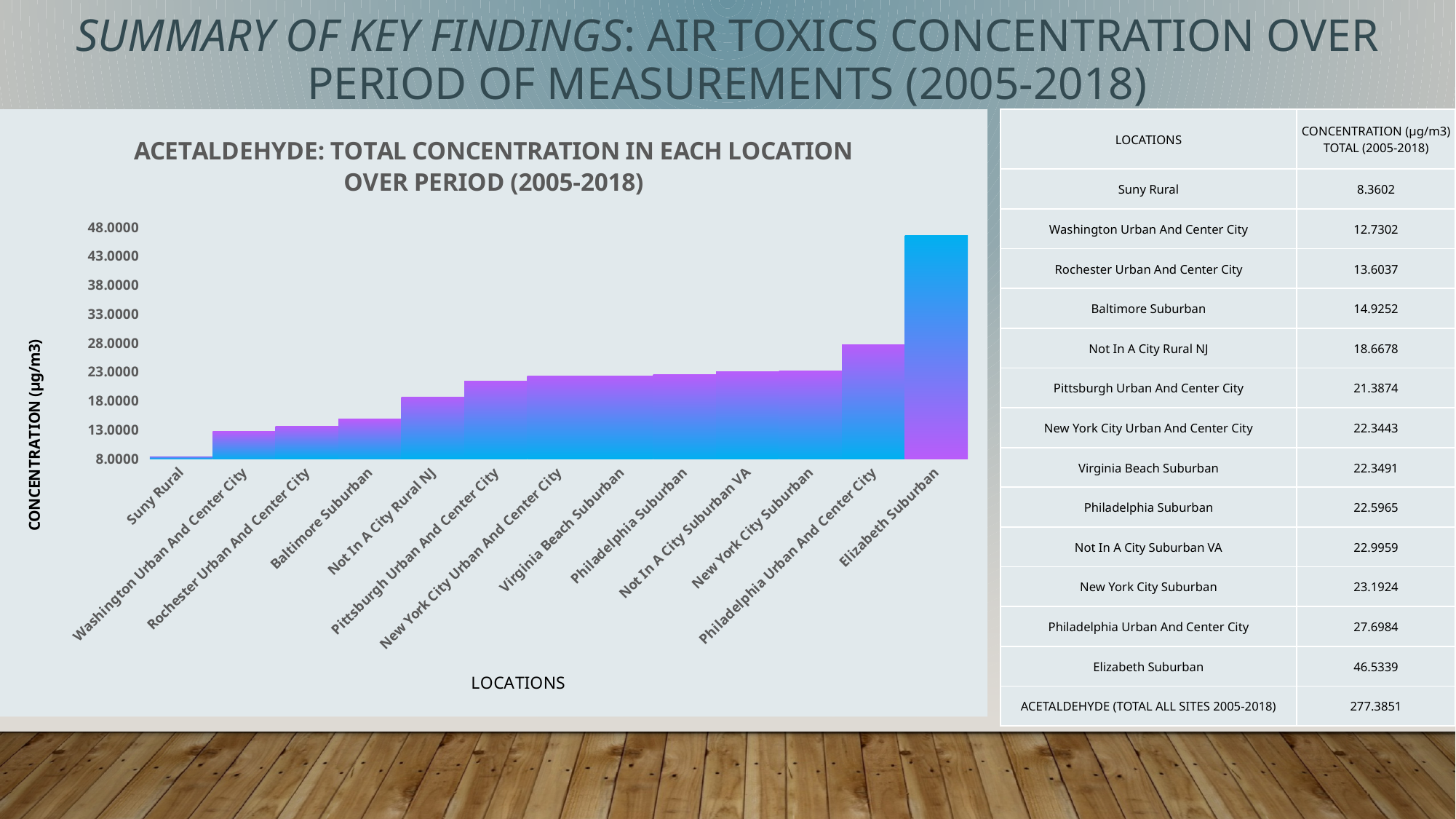
Is the value for Elizabeth Suburban greater or less than 43.0000? greater Which location has the highest total acetaldehyde concentration? Elizabeth Suburban What is the total acetaldehyde concentration for Baltimore Suburban? 14.9252 How many locations are plotted in the bar chart? 13 What kind of chart is shown on the slide? bar chart What is the difference between the values for Elizabeth Suburban and Suny Rural? 38.1737 Which is larger, the value for Pittsburgh Urban And Center City or the value for Philadelphia Urban And Center City? Philadelphia Urban And Center City Which location has the lowest total acetaldehyde concentration? Suny Rural What is the total acetaldehyde concentration for Elizabeth Suburban? 46.5339 Do the values rise or fall from left to right along the x axis? rise What is the total acetaldehyde concentration for Philadelphia Urban And Center City? 27.6984 Is the value for Not In A City Rural NJ greater or less than 23.0000? less